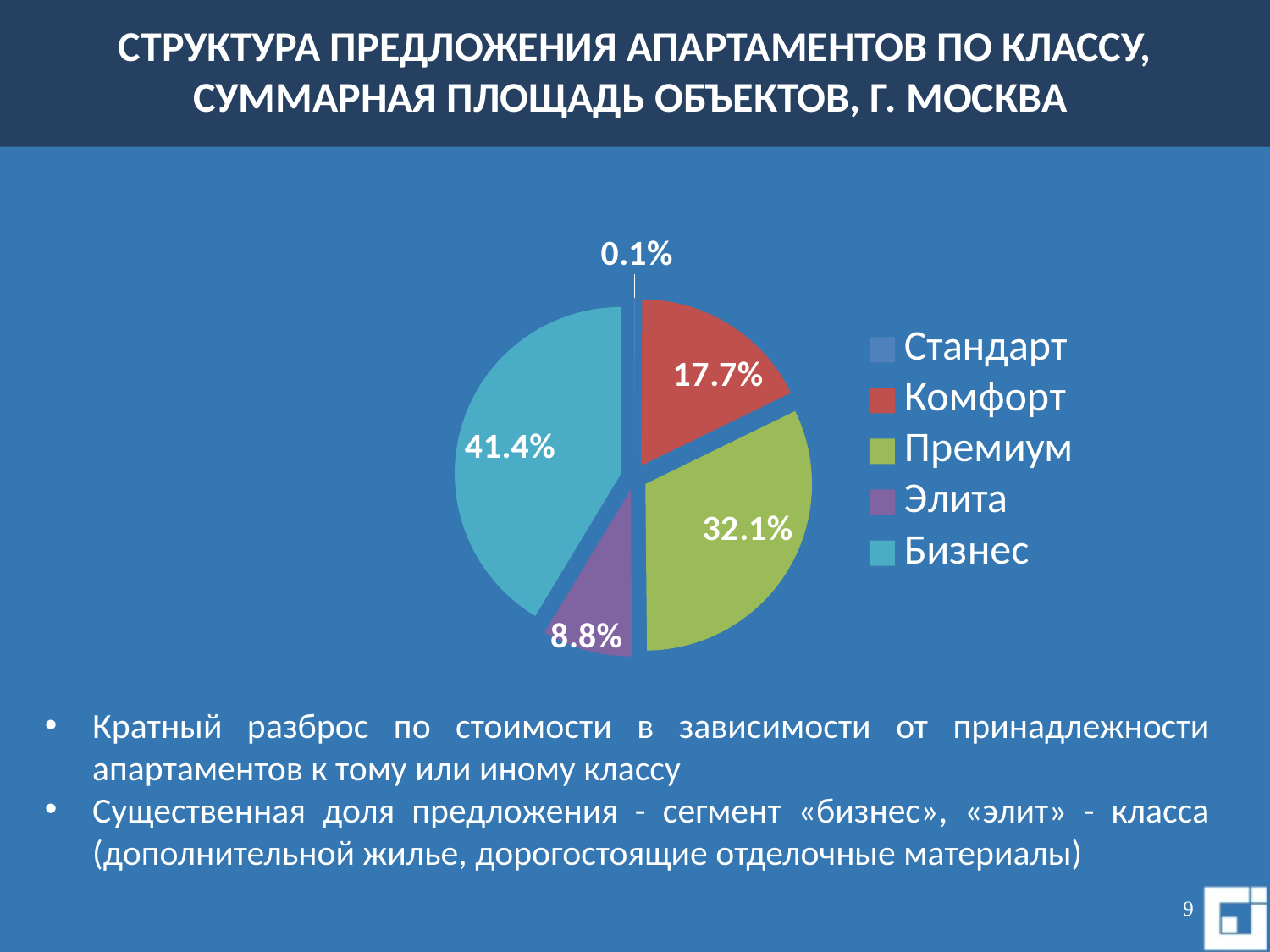
How many categories does the pie chart show? 5 What share of the pie does Премиум have? 32.1% What is the difference between the shares of Бизнес and Премиум? 9.3% Which has a larger share, Комфорт or Элита? Комфорт What share of the pie does Комфорт have? 17.7% What share of the pie does Стандарт have? 0.1% What colour is the Премиум slice in the pie chart? Green What share of the pie does Элита have? 8.8% Which category has the largest share of the pie? Бизнес What share of the pie does Бизнес have? 41.4% Which category has the smallest share of the pie? Стандарт What kind of chart is shown on the slide? Pie chart